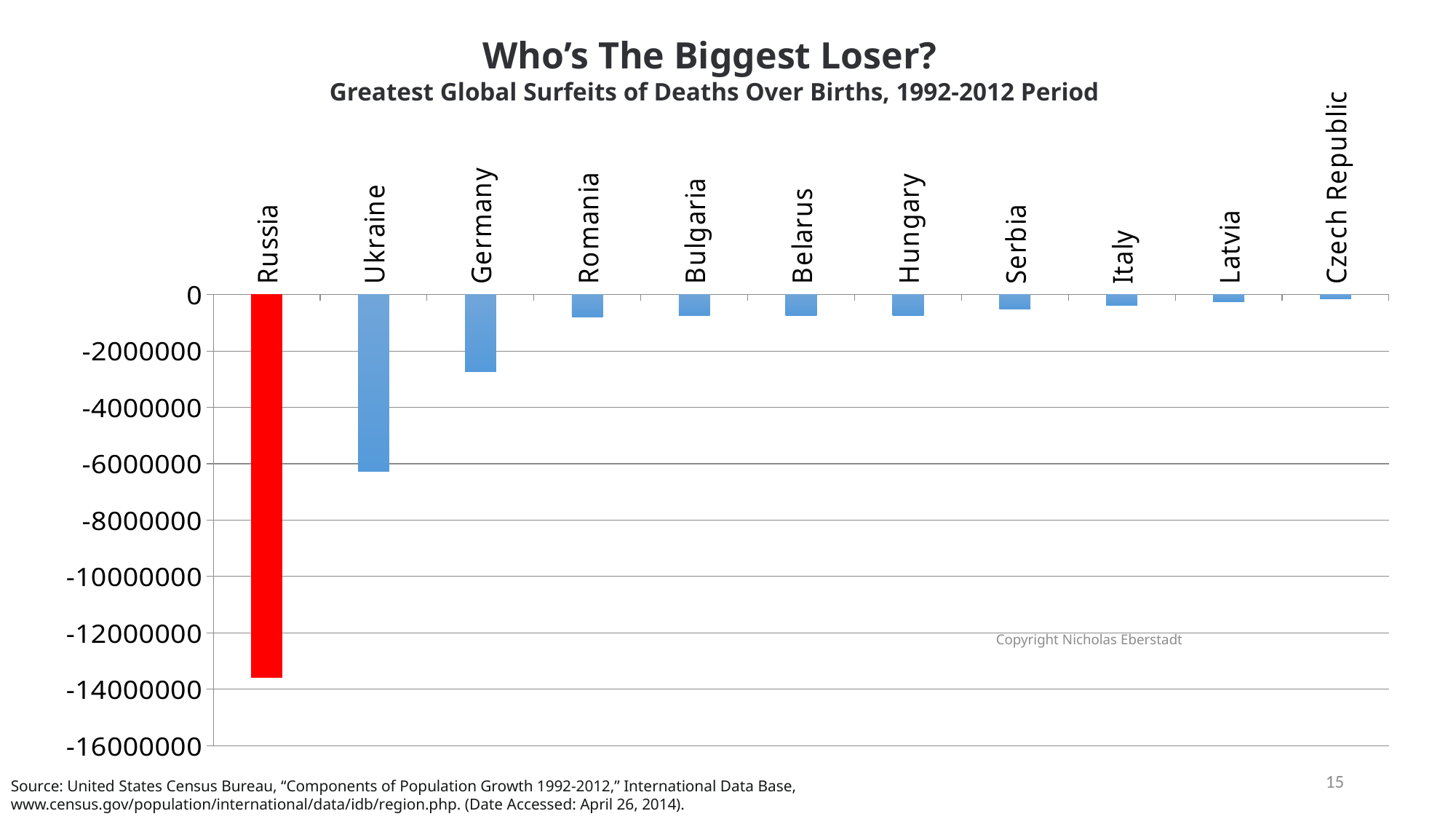
Which has the larger (less negative) value, Germany or Romania? Romania Is the value for Germany greater or less than -2000000? less Is the value for Ukraine greater or less than -6000000? less Is the value for Russia greater or less than -12000000? less Which country has the lowest (most negative) value in the chart? Russia Which has the larger (less negative) value, Russia or Ukraine? Ukraine What kind of chart is shown on the slide? bar chart Do the values rise or fall moving from left to right along the x axis? rise Which country has the value closest to zero in the chart? Czech Republic How many countries are plotted in the chart? 11 Which country's bar is coloured red? Russia